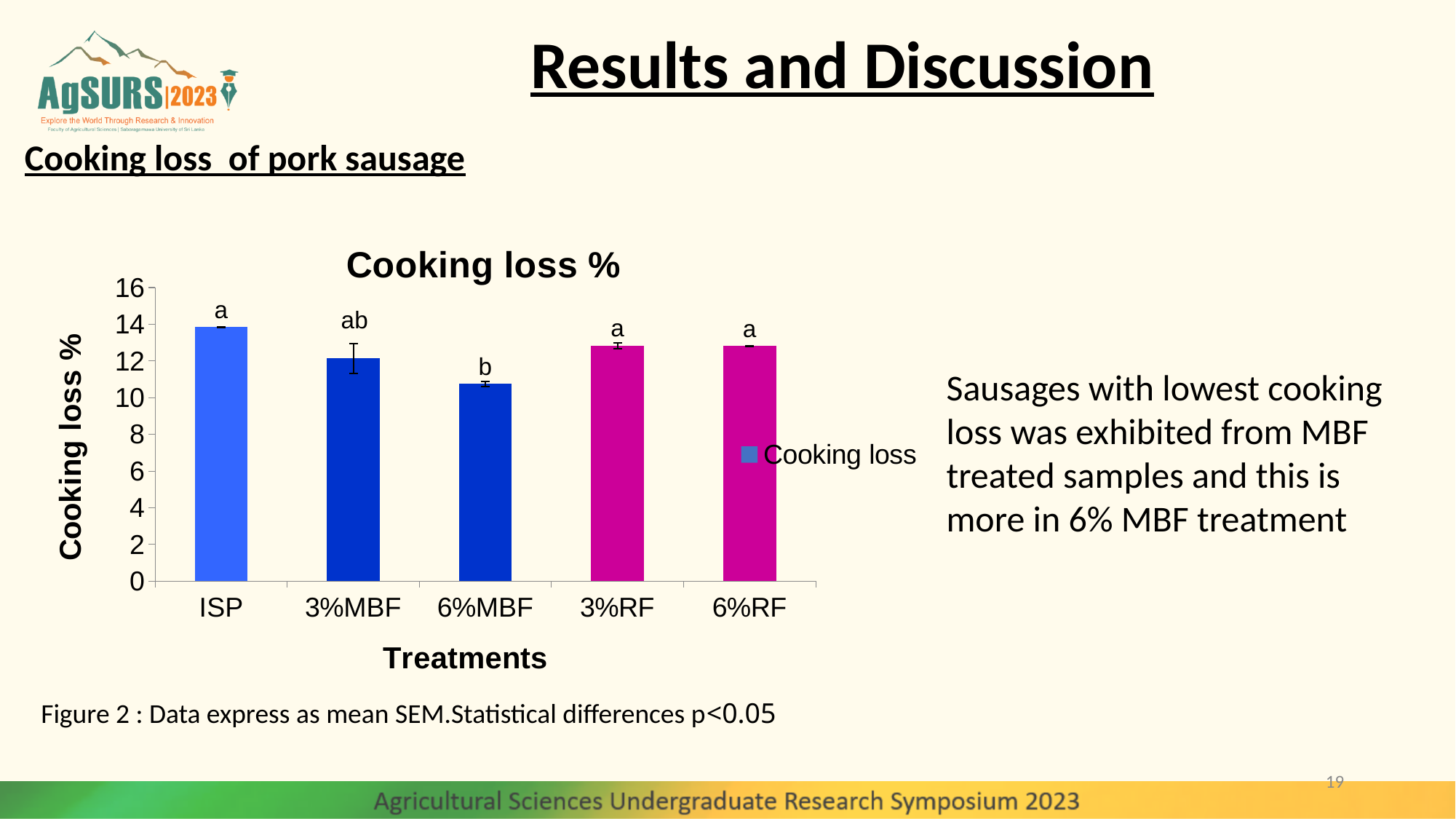
What is the x-axis title of the chart? Treatments How many treatment categories are plotted on the x axis? 5 Which has a higher cooking loss, 3%MBF or 6%MBF? 3%MBF What kind of chart is shown on the slide? bar chart Is the cooking loss for 3%MBF greater or less than 10? greater Is the cooking loss for 3%RF greater or less than 14? less Is the cooking loss for 6%MBF greater or less than 12? less How many series does the legend list? 1 Which treatment has the lowest cooking loss? 6%MBF What is the title of the chart? Cooking loss % Which treatment has the highest cooking loss? ISP